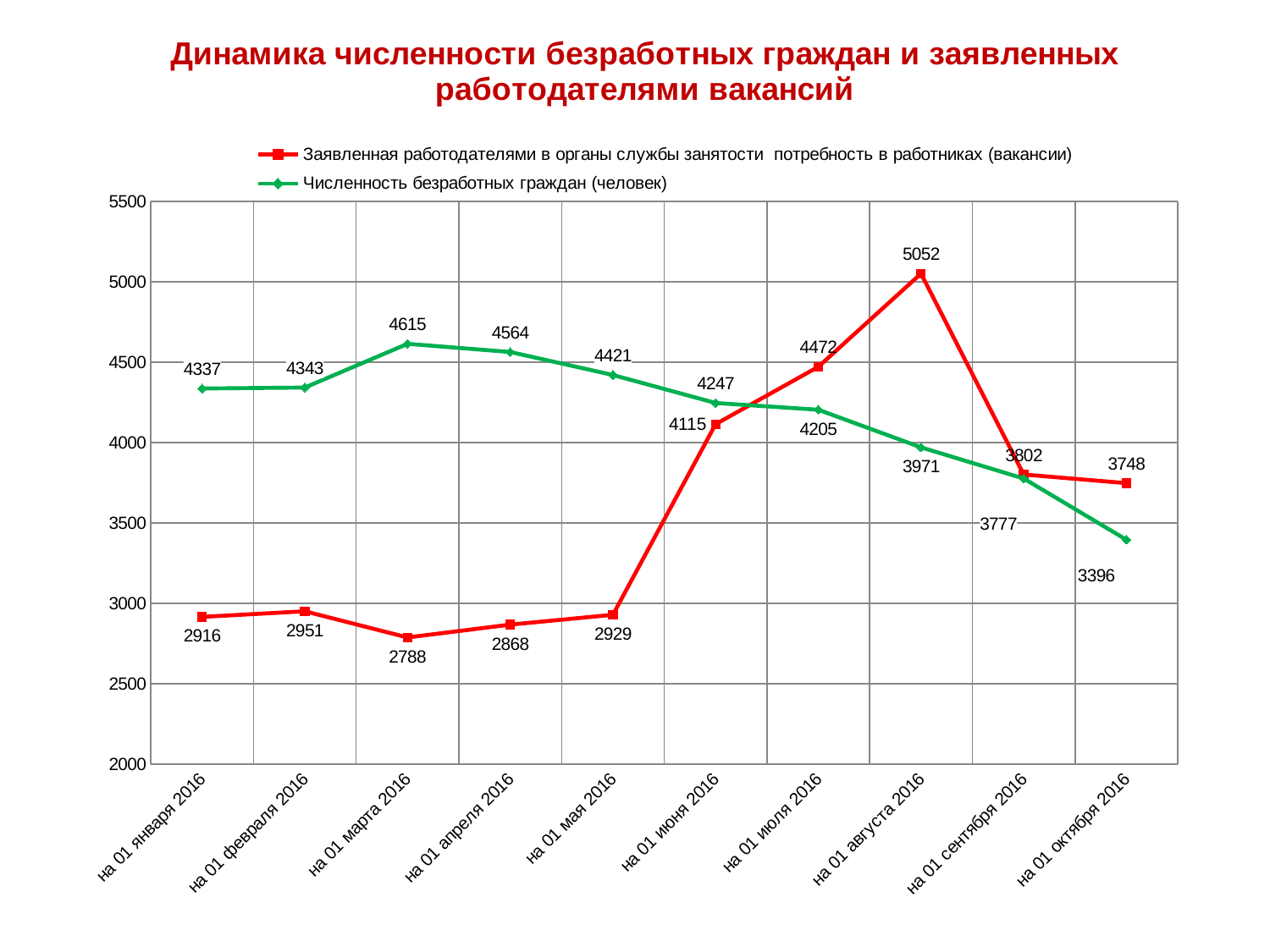
On which date is the number of vacancies (red series) the lowest? на 01 марта 2016 On which date is the number of unemployed citizens (green series) the highest? на 01 марта 2016 What is the value of 'Заявленная работодателями в органы службы занятости потребность в работниках (вакансии)' on 01 августа 2016? 5052 How many series does the legend list? 2 What is the value of 'Численность безработных граждан (человек)' on 01 марта 2016? 4615 What type of chart is shown on the slide? line chart On 01 июня 2016, which is larger: the number of vacancies or the number of unemployed citizens? the number of unemployed citizens What colour is the line for 'Численность безработных граждан (человек)'? green How many dates are plotted along the x axis? 10 What is the value of the green series on 01 октября 2016? 3396 What is the difference between the number of vacancies and the number of unemployed citizens on 01 августа 2016? 1081 Does the number of unemployed citizens (green series) rise or fall from 01 марта 2016 to 01 октября 2016? fall